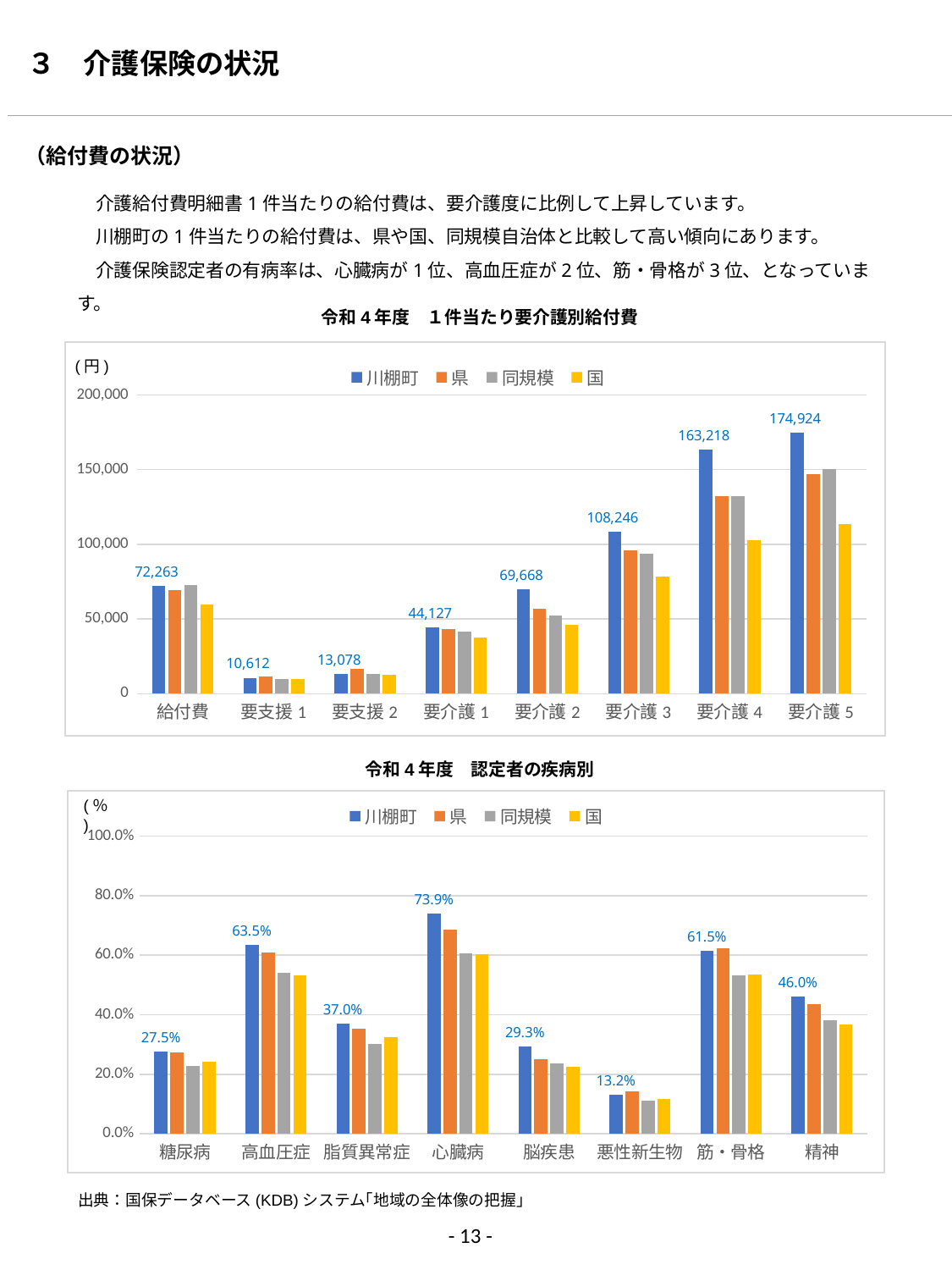
In the chart titled 令和4年度 1件当たり要介護別給付費, what is the difference between the 川棚町 values for 要介護5 and 要介護4? 11,706 In the chart titled 令和4年度 認定者の疾病別, what is the 川棚町 value for 心臓病? 73.9% In the chart titled 令和4年度 1件当たり要介護別給付費, what is the value for 川棚町 in the 要介護5 category? 174,924 In the chart titled 令和4年度 認定者の疾病別, how many disease categories are shown on the x axis? 8 In the chart titled 令和4年度 認定者の疾病別, which is larger for 川棚町: 高血圧症 or 筋・骨格? 高血圧症 What kind of chart is the chart titled 令和4年度 認定者の疾病別? bar chart In the chart titled 令和4年度 1件当たり要介護別給付費, do the 川棚町 values rise or fall from 要支援1 to 要介護5? rise In the chart titled 令和4年度 認定者の疾病別, which category has the lowest 川棚町 value? 悪性新生物 In the chart titled 令和4年度 1件当たり要介護別給付費, how many series does the legend list? 4 In the chart titled 令和4年度 1件当たり要介護別給付費, is the 国 value for 要介護4 greater or less than 150,000? less In the chart titled 令和4年度 1件当たり要介護別給付費, what is the value for 川棚町 in the 要支援1 category? 10,612 In the chart titled 令和4年度 1件当たり要介護別給付費, which category has the highest 川棚町 value? 要介護5